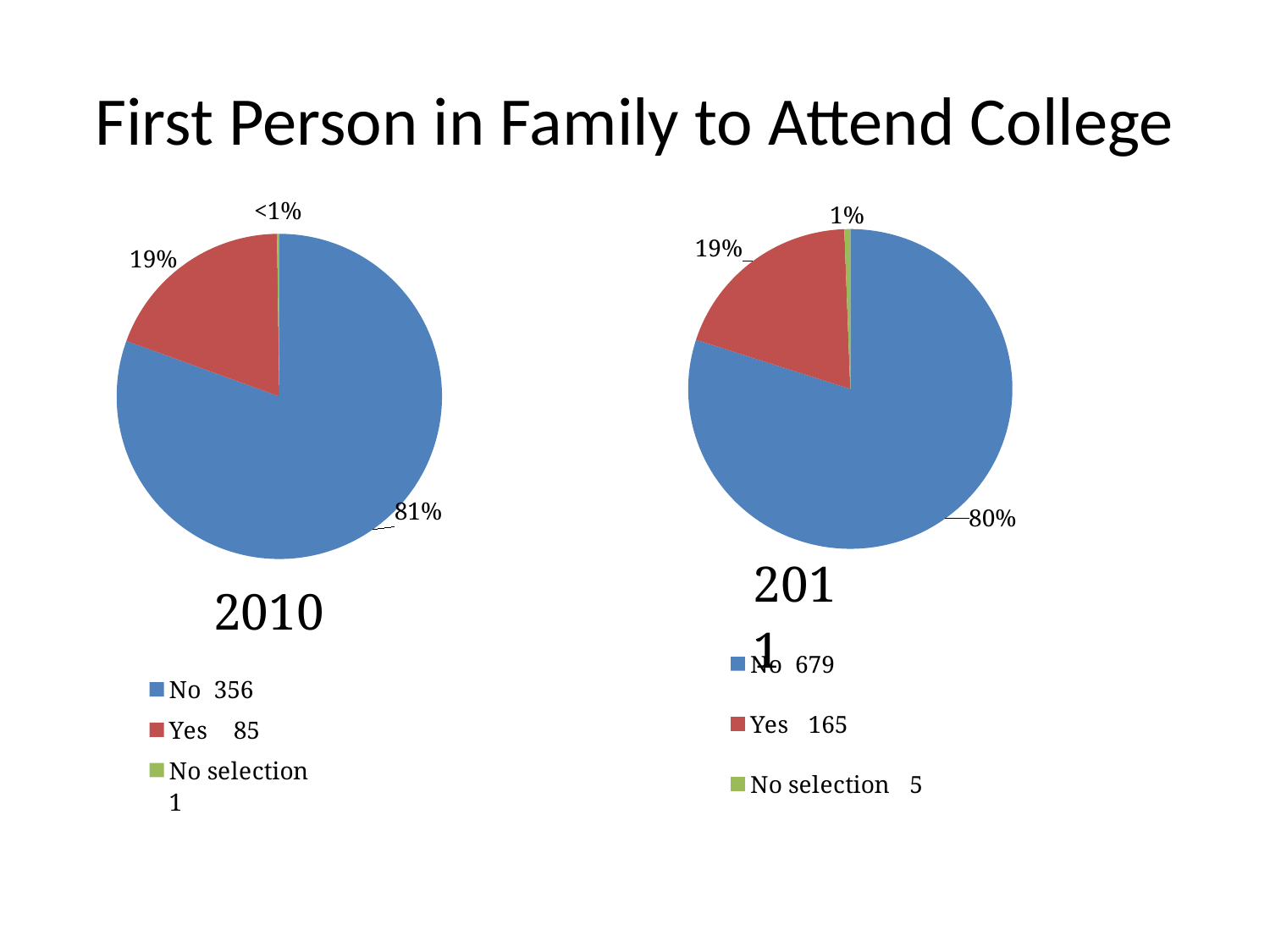
According to the legend of the 2011 pie chart, how many respondents answered 'Yes'? 165 In the 2011 pie chart, what percentage is shown for the 'No selection' slice? 1% In the 2010 pie chart, what percentage is shown for the 'Yes' slice? 19% In the 2011 pie chart, which category has the smallest slice? No selection In the 2011 pie chart, what percentage is shown for the 'No' slice? 80% In the 2011 pie chart, is the 'Yes' slice larger or smaller than the 'No' slice? smaller According to the legend of the 2010 pie chart, how many respondents answered 'No'? 356 In the 2010 pie chart, what percentage is shown for the 'No' slice? 81% In the 2010 pie chart, which category has the largest slice? No What kind of chart is shown for 2010 on the left of the slide? pie chart In the 2010 pie chart, what percentage label is shown for the 'No selection' slice? <1% How many categories does the legend of the 2011 pie chart list? 3